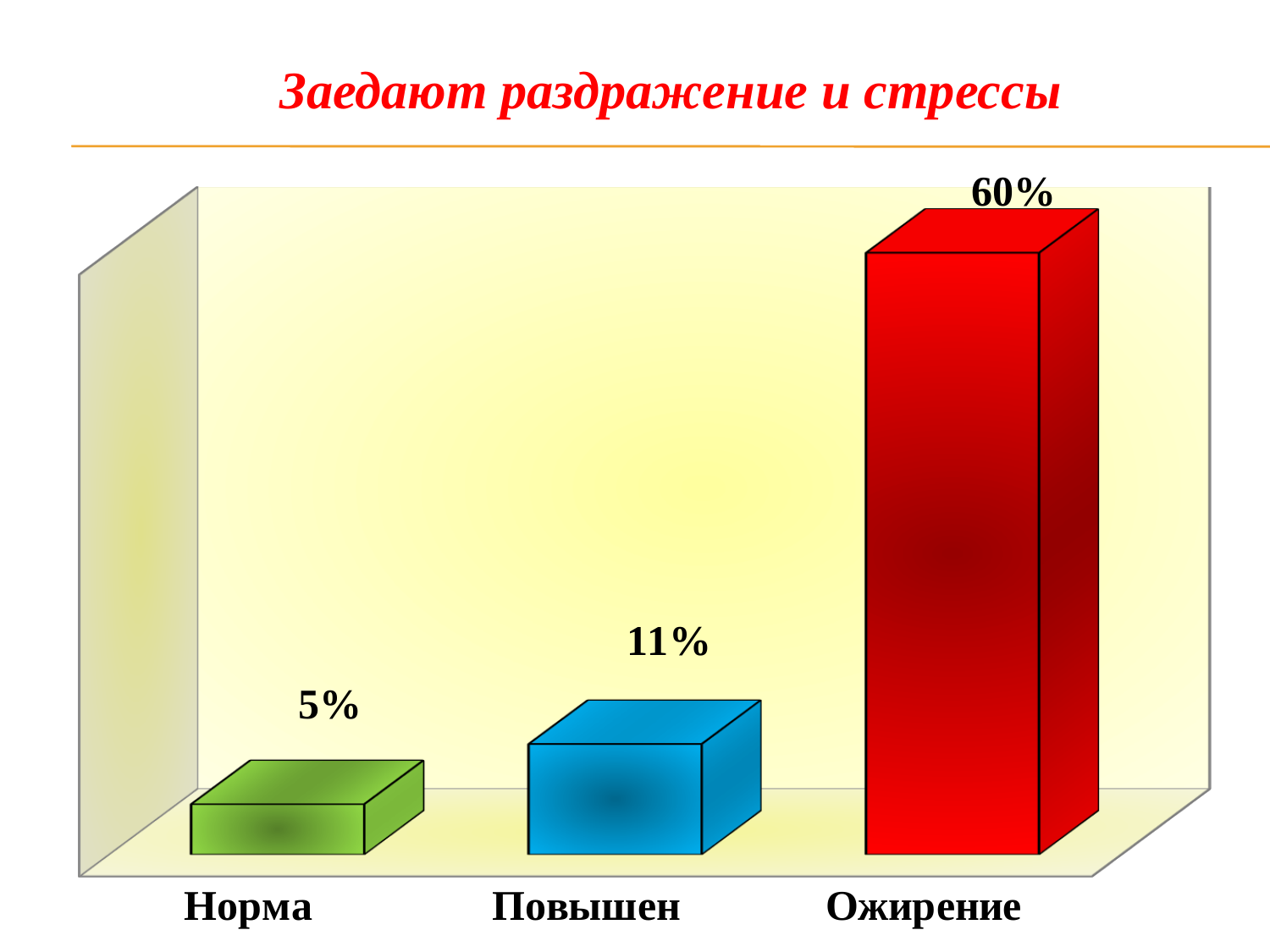
How many categories are shown in the chart? 3 What is the value for Повышен? 11% Which category has the lowest value? Норма Which is larger, the value for Повышен or the value for Норма? Повышен What is the difference between the values for Ожирение and Повышен? 49% What is the value for Ожирение? 60% What is the difference between the values for Повышен and Норма? 6% What kind of chart is shown on the slide? bar chart Do the values rise or fall from left to right across the categories? rise What is the value for Норма? 5% What is the title of the slide? Заедают раздражение и стрессы Which category has the highest value? Ожирение